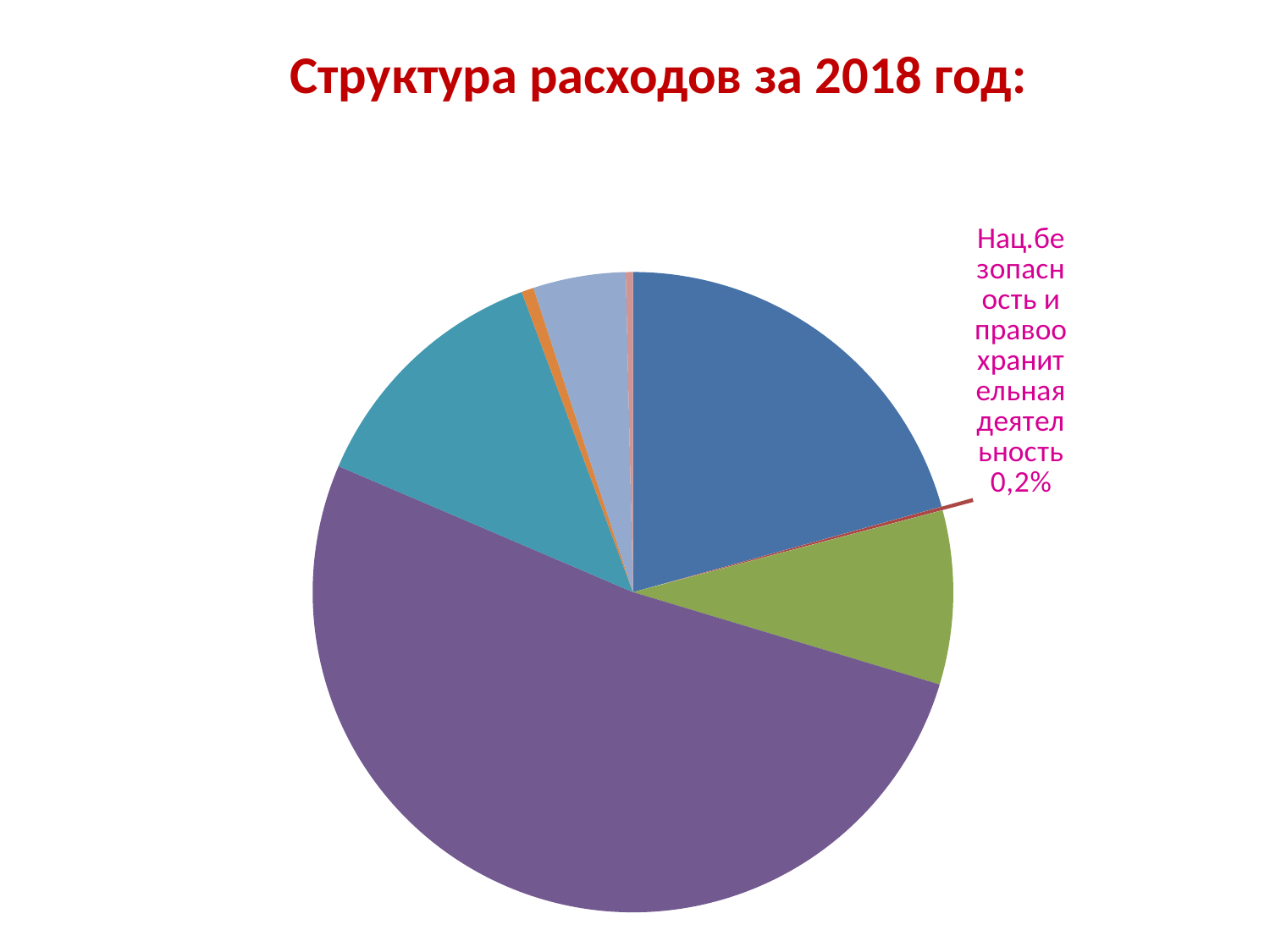
How many slices have a printed data label on the chart? 1 Does the purple slice take up more or less than half of the pie? more What is the title of the chart? Структура расходов за 2018 год: What share of expenses is labelled for "Нац.безопасность и правоохранительная деятельность"? 0,2% Is the slice for "Нац.безопасность и правоохранительная деятельность" the smallest labelled slice on the chart? yes What kind of chart is shown on the slide? pie chart Which colour slice is the largest in the pie chart? purple Which is larger, the green slice or the teal slice? the teal slice What is the value shown for the slice "Нац.безопасность и правоохранительная деятельность"? 0,2% Which is larger, the purple slice or the blue slice? the purple slice